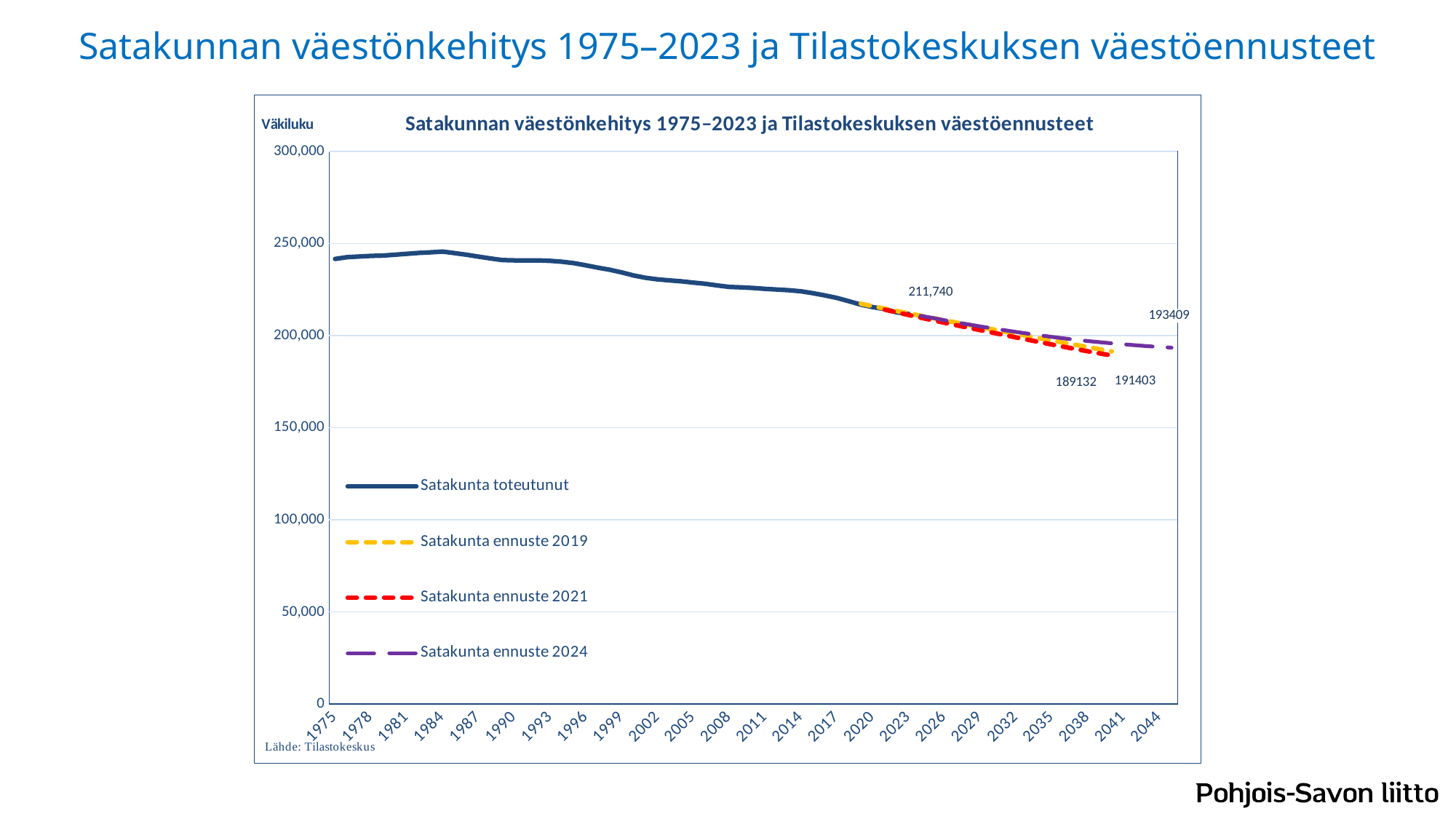
How many series does the legend list? 4 What is the final labelled value of the Satakunta ennuste 2024 series? 193409 Which forecast series ends at the highest labelled value? Satakunta ennuste 2024 What label is shown on the vertical axis of the chart? Väkiluku Is the value for Satakunta toteutunut in 1975 greater or less than 200,000? greater What is the final labelled value of the Satakunta ennuste 2021 series? 189132 What kind of chart is shown on the slide? line chart What is the difference between the final labelled values of Satakunta ennuste 2019 and Satakunta ennuste 2021? 2271 What is the largest data label printed on the chart? 211,740 Which forecast series ends at the lowest labelled value? Satakunta ennuste 2021 Does the Satakunta toteutunut line generally rise or fall from 1984 to 2023? fall What is the final labelled value of the Satakunta ennuste 2019 series? 191403